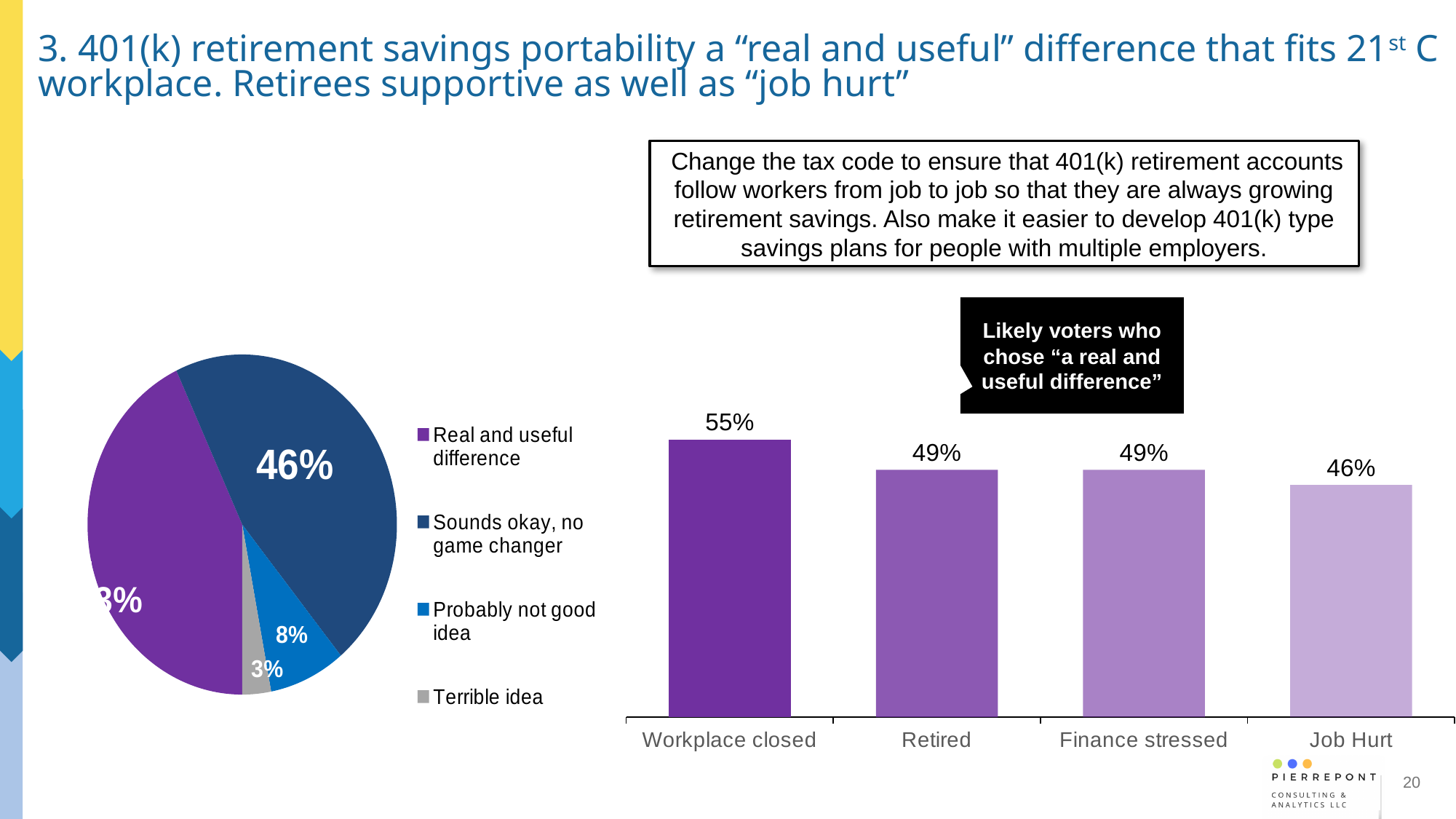
In the bar chart on the right, what is the value for Job Hurt? 46% How many entries does the legend of the pie chart on the left list? 4 In the bar chart on the right, what percentage of likely voters in the Workplace closed group chose "a real and useful difference"? 55% In the bar chart on the right, which is larger: the value for Workplace closed or the value for Finance stressed? Workplace closed In the bar chart on the right, what is the value for Retired? 49% In the bar chart on the right, which group has the highest value? Workplace closed How many groups are shown in the bar chart on the right? 4 What kind of chart is on the right side of the slide? Bar chart In the bar chart on the right, which group has the lowest value? Job Hurt In the pie chart on the left, what share of respondents said "Sounds okay, no game changer"? 46% In the pie chart on the left, which response has the smallest share? Terrible idea In the bar chart on the right, what is the difference between the Workplace closed value and the Job Hurt value? 9 percentage points